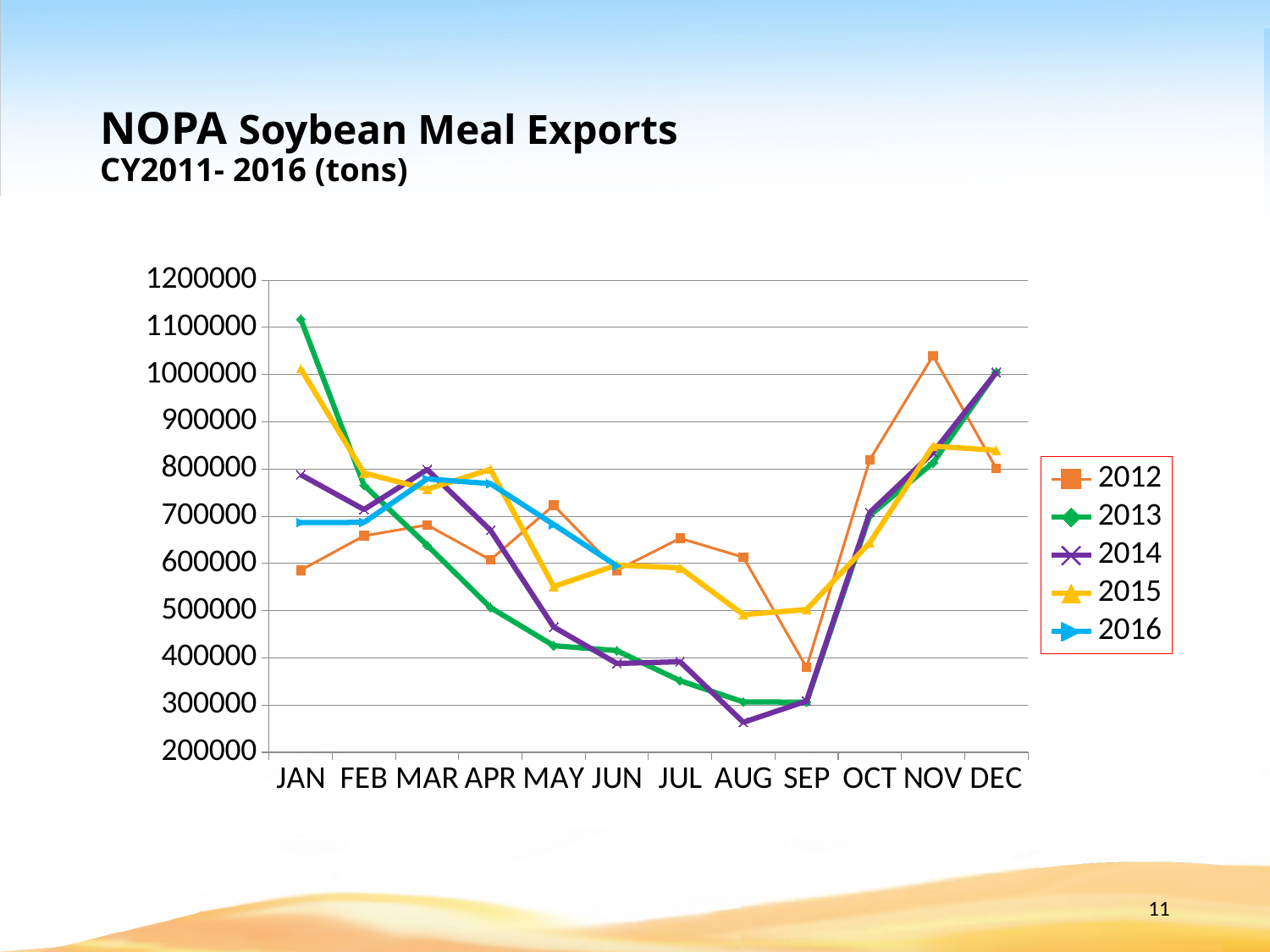
Is the value for 2014 in AUG greater or less than 300000? less In which month is the 2013 series at its highest? JAN Is the value for 2012 in SEP greater or less than 400000? less In which month is the 2014 series at its lowest? AUG What kind of chart is shown on the slide? line chart Which series has the larger value in NOV, 2012 or 2013? 2012 How many months have a plotted value for the 2016 series? 6 How many series does the legend list? 5 How many months are shown along the x axis? 12 Is the value for 2015 in MAY greater or less than 600000? less In which month is the 2012 series at its highest? NOV